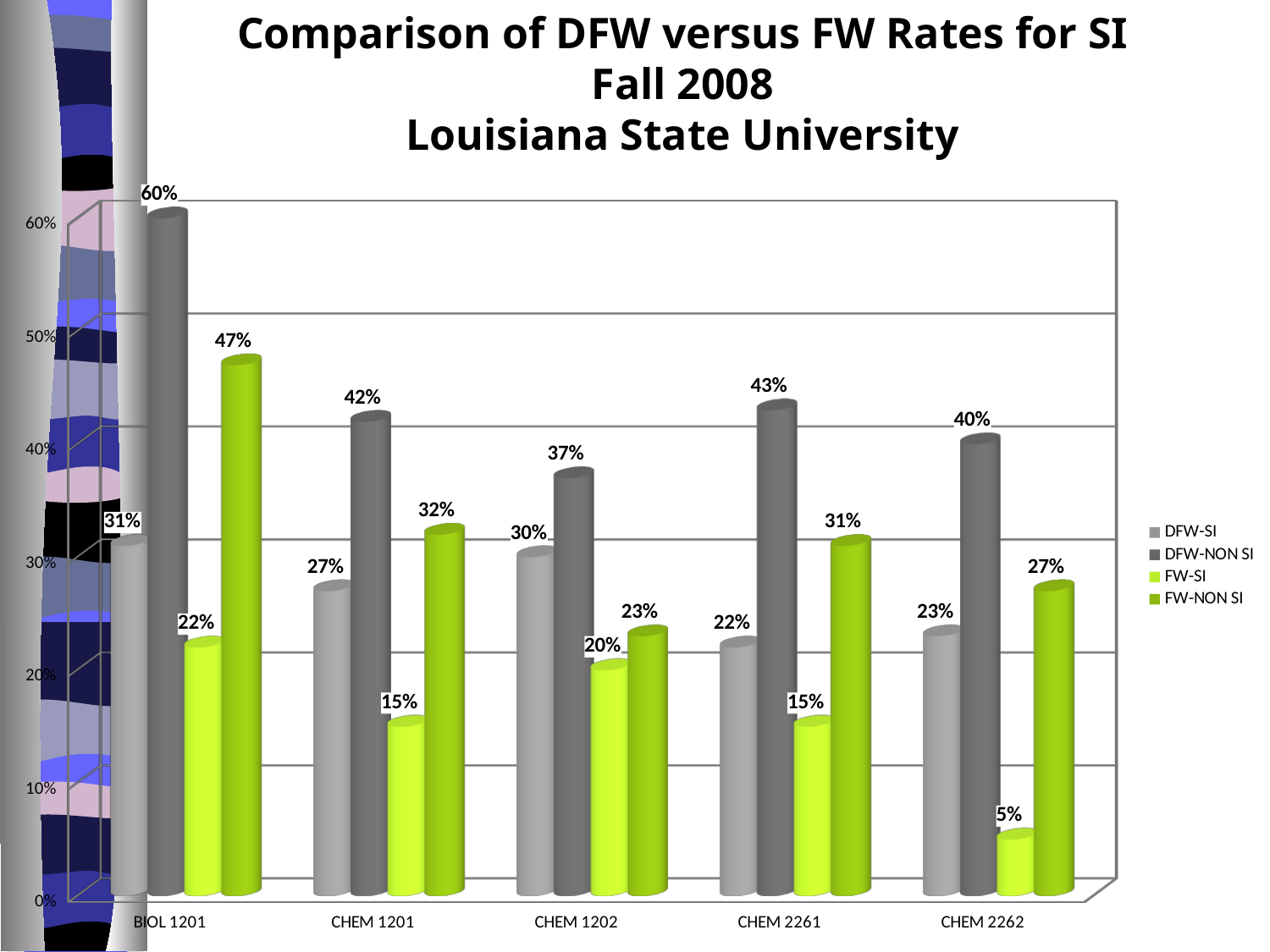
How many courses are shown on the x axis? 5 Which legend entry is shown in light green? FW-SI What is the DFW-NON SI rate for BIOL 1201? 60% How many series does the legend list? 4 Which course has the lowest FW-SI rate? CHEM 2262 Which course has the highest DFW-NON SI rate? BIOL 1201 What is the FW-NON SI rate for CHEM 2261? 31% What is the FW-SI rate for CHEM 2262? 5% Which is larger for CHEM 1201: the FW-NON SI rate or the DFW-SI rate? FW-NON SI What kind of chart is shown on the slide? Bar chart What is the DFW-SI rate for CHEM 1202? 30% What is the difference between the DFW-NON SI and DFW-SI rates for BIOL 1201? 29%